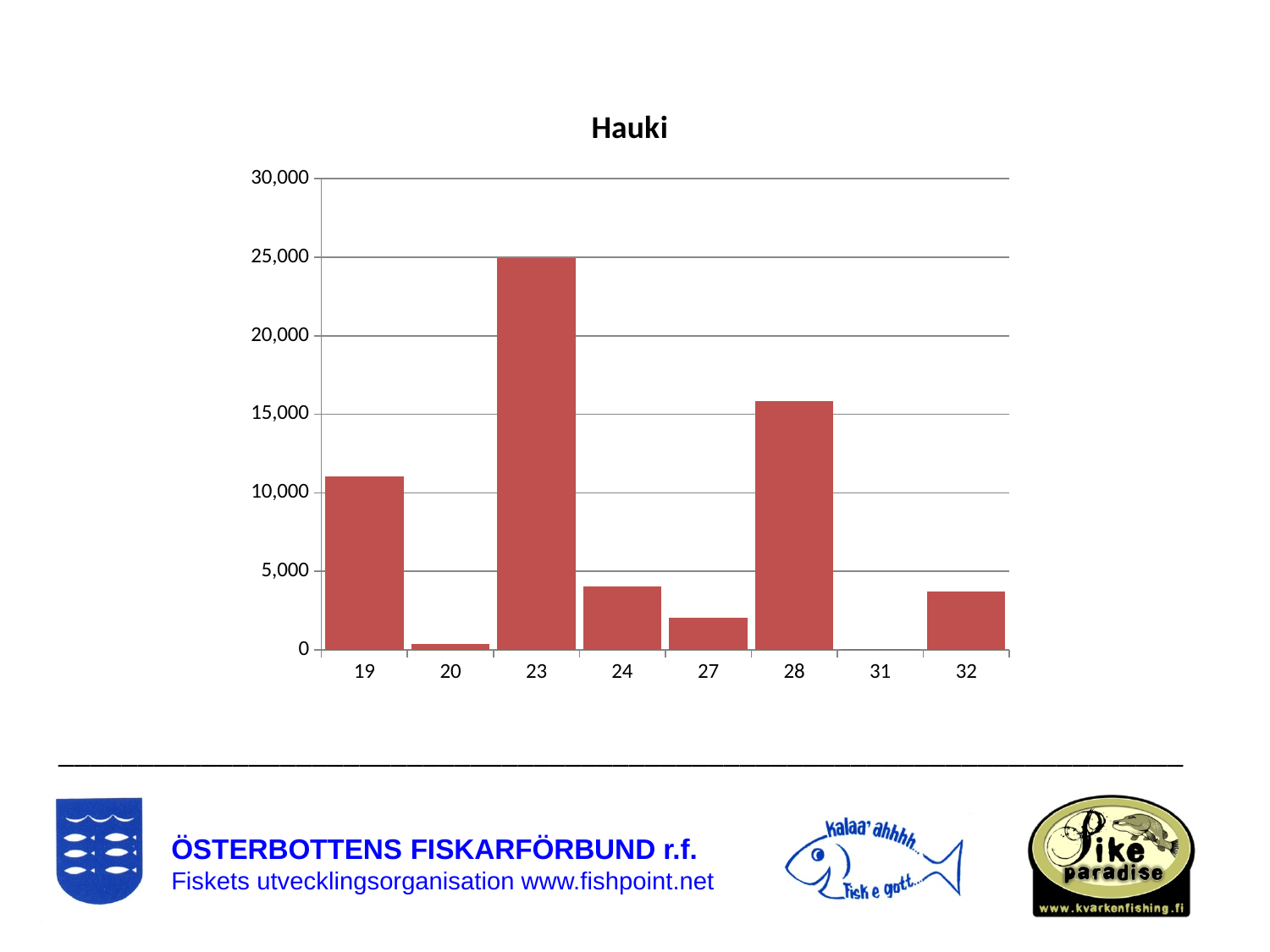
How many categories are shown on the x axis of the chart? 8 Which category has the lowest value in the chart? 31 What kind of chart is shown on the slide? bar chart Is the value for category 28 greater or less than 20,000? less Is the value for category 24 greater or less than 5,000? less Which has the larger value, category 24 or category 27? 24 Is the value for category 19 greater or less than 10,000? greater Which has the larger value, category 19 or category 28? 28 Which category has the highest value in the chart? 23 What is the title of the chart? Hauki Which has the larger value, category 20 or category 32? 32